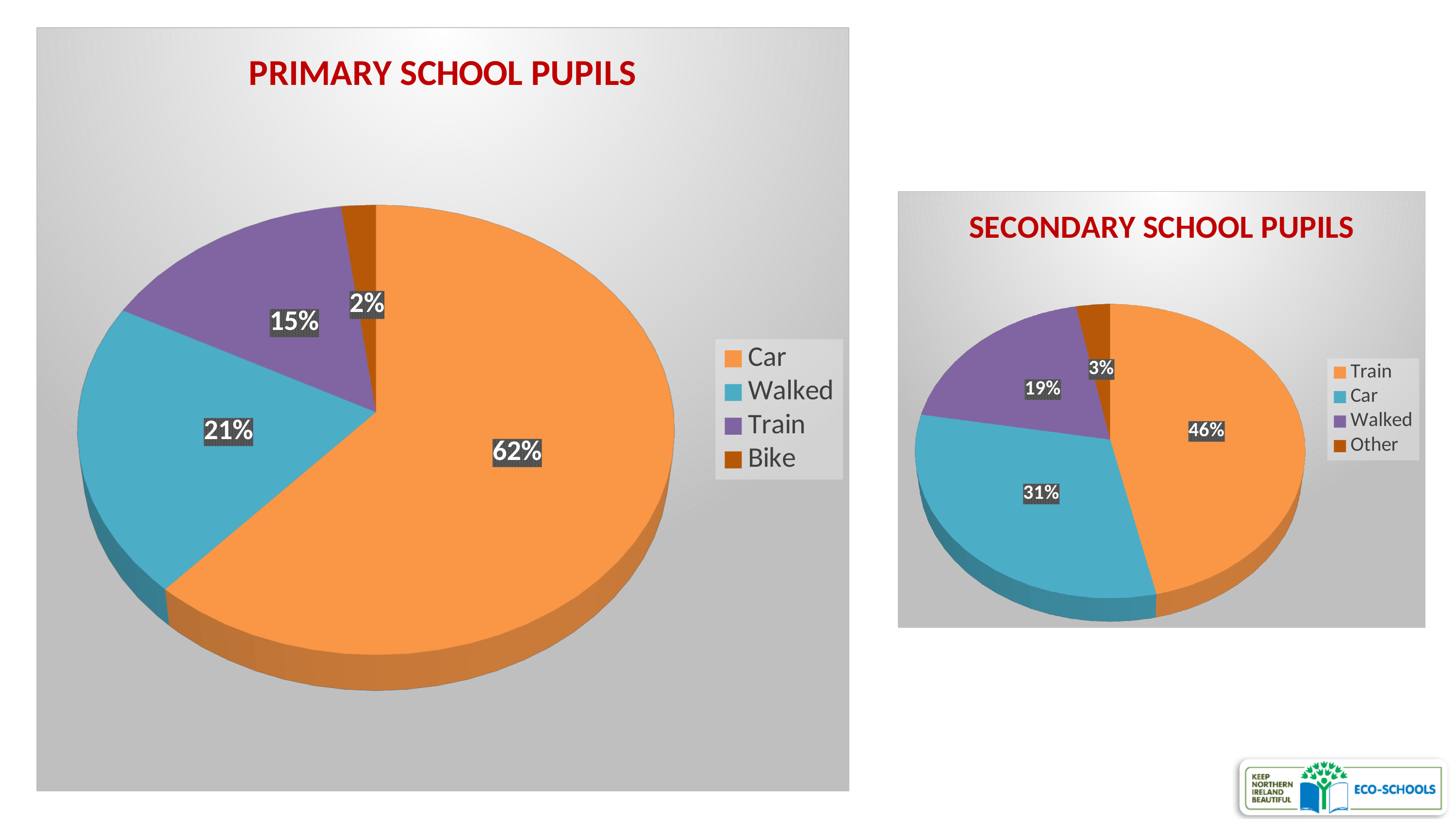
In the PRIMARY SCHOOL PUPILS chart, which category has the smallest slice? Bike In the PRIMARY SCHOOL PUPILS chart, which category has the largest slice? Car In the SECONDARY SCHOOL PUPILS chart, which is larger, the Car slice or the Walked slice? Car In the SECONDARY SCHOOL PUPILS chart, what is the difference between the Train and Car shares? 15% In the SECONDARY SCHOOL PUPILS chart, what share of pupils travel by Train? 46% In the SECONDARY SCHOOL PUPILS chart, what share of pupils Walked? 19% What kind of chart is the PRIMARY SCHOOL PUPILS chart? Pie chart In the PRIMARY SCHOOL PUPILS chart, what share of pupils Walked? 21% In the PRIMARY SCHOOL PUPILS chart, what is the difference between the Car and Walked shares? 41% In the PRIMARY SCHOOL PUPILS chart, what share of pupils travel by Car? 62% In the PRIMARY SCHOOL PUPILS chart, which colour represents Train? Purple How many categories does the legend of the SECONDARY SCHOOL PUPILS chart list? 4